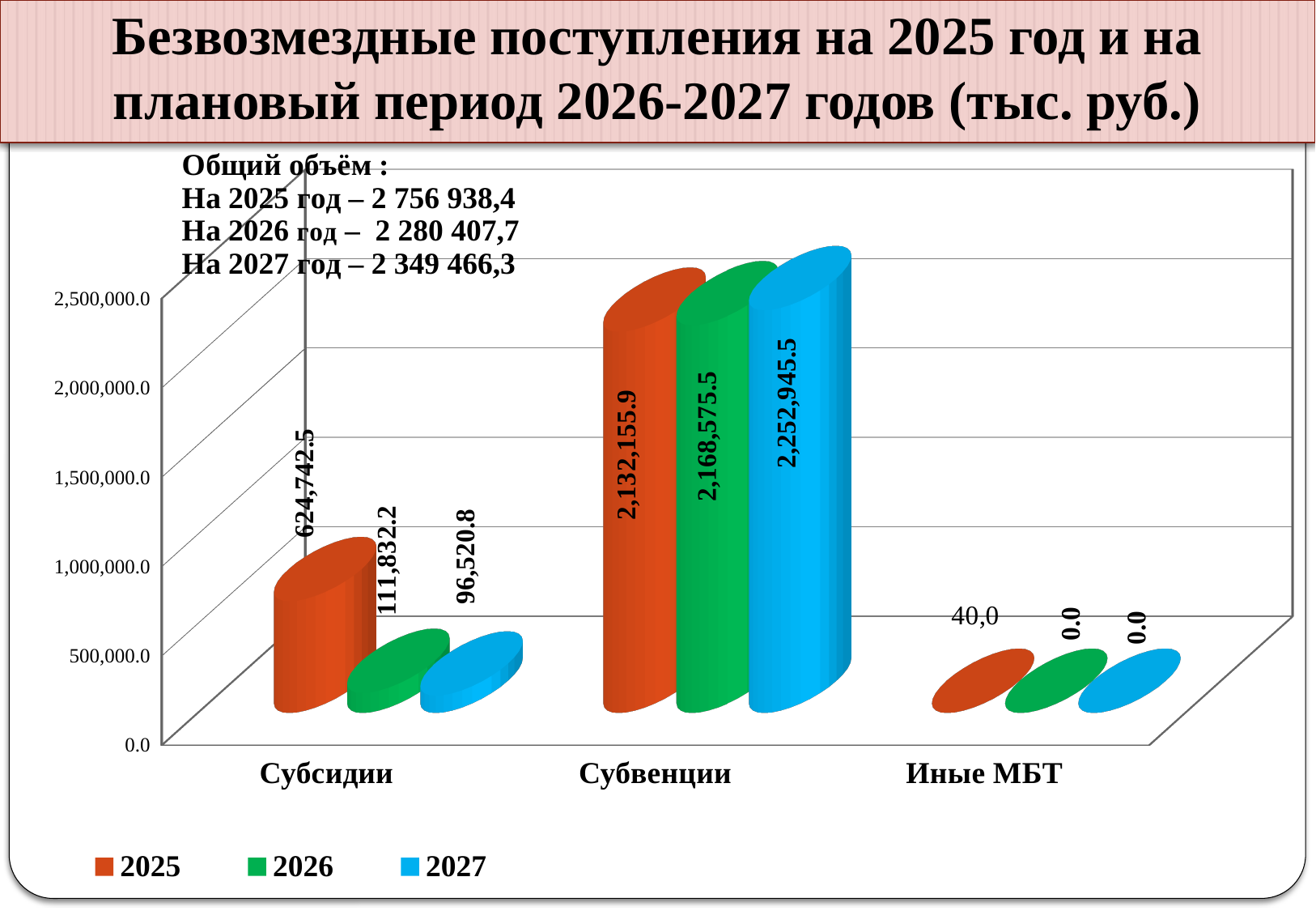
What is the difference between the 2027 and 2025 values for Субвенции? 120,789.6 Which category has the highest value in 2026? Субвенции What is the value for Субсидии in 2025? 624,742.5 How many categories are shown on the x axis? 3 Which is larger: the 2025 value for Субсидии or the 2026 value for Субсидии? 2025 value for Субсидии What is the value for Субвенции in 2027? 2,252,945.5 What is the value for Субсидии in 2027? 96,520.8 What is the value for Иные МБТ in 2026? 0.0 Which year has the lowest value for Субсидии? 2027 Which series is shown in blue in the legend? 2027 How many series does the legend list? 3 What type of chart is shown on the slide? bar chart